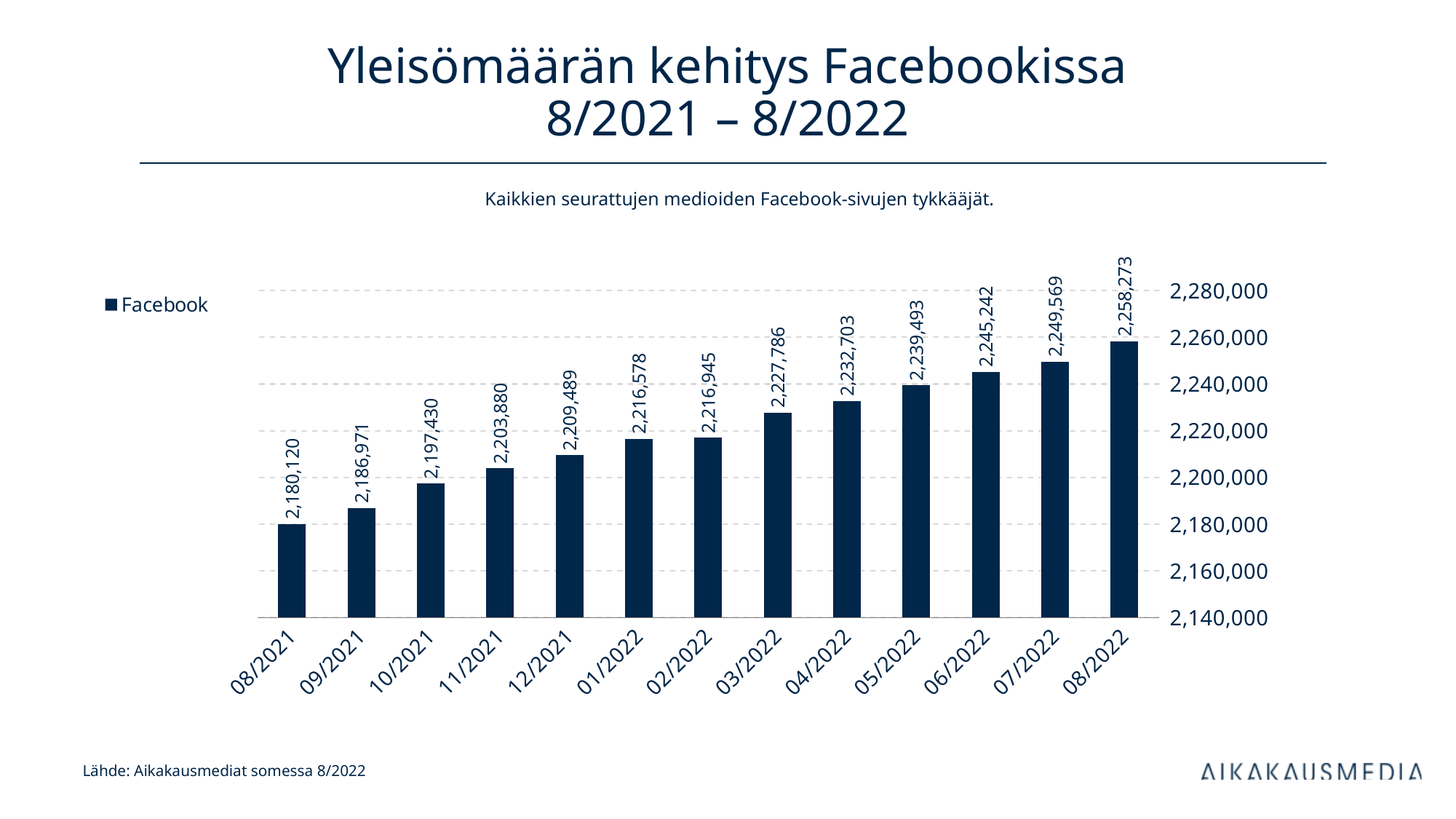
Which is larger, the Facebook value for 05/2022 or for 04/2022? 05/2022 Which month has the lowest Facebook value? 08/2021 What is the difference between the Facebook values for 12/2021 and 11/2021? 5,609 Which month has the highest Facebook value? 08/2022 What is the Facebook value for 08/2022? 2,258,273 What is the difference between the Facebook values for 08/2022 and 08/2021? 78,153 What is the Facebook value for 08/2021? 2,180,120 Is the Facebook value for 10/2021 greater or less than 2,200,000? less What kind of chart is shown on the slide? bar chart Do the Facebook values rise or fall from 08/2021 to 08/2022? rise What is the Facebook value for 03/2022? 2,227,786 How many months are shown on the x axis? 13